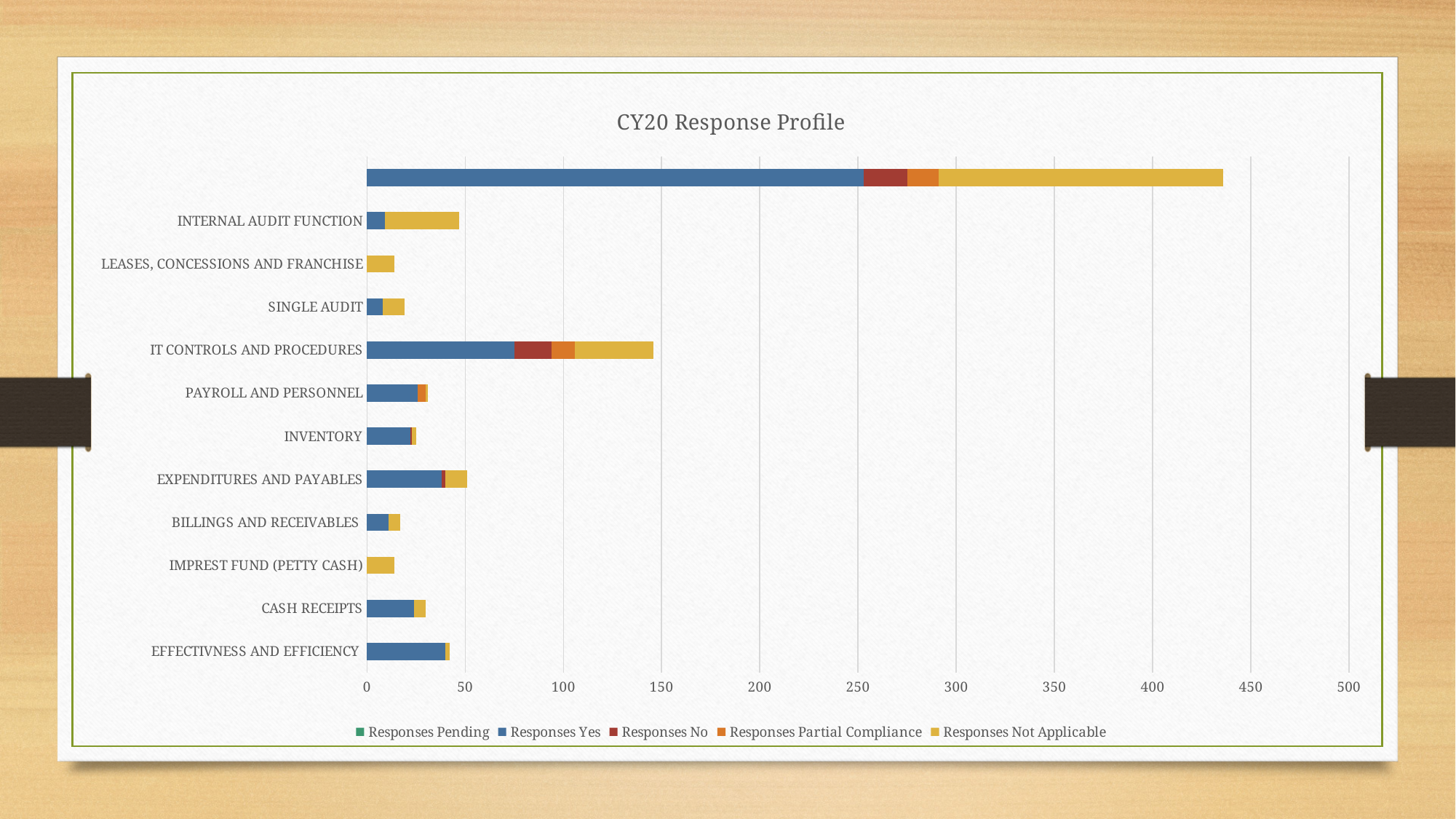
Is the total bar for EFFECTIVNESS AND EFFICIENCY greater or less than 50? less Which has the longer total bar, PAYROLL AND PERSONNEL or INVENTORY? PAYROLL AND PERSONNEL How many category labels are listed on the vertical axis? 11 What kind of chart is shown on the slide? Stacked bar chart Is the total bar for IT CONTROLS AND PROCEDURES greater or less than 100? greater Among the labeled categories, which has the longest total bar? IT CONTROLS AND PROCEDURES How many series does the legend list? 5 Which has the longer total bar, IT CONTROLS AND PROCEDURES or INTERNAL AUDIT FUNCTION? IT CONTROLS AND PROCEDURES Is the unlabeled top bar greater or less than 400? greater Which legend entry is shown in yellow/gold? Responses Not Applicable What is the title of the chart? CY20 Response Profile